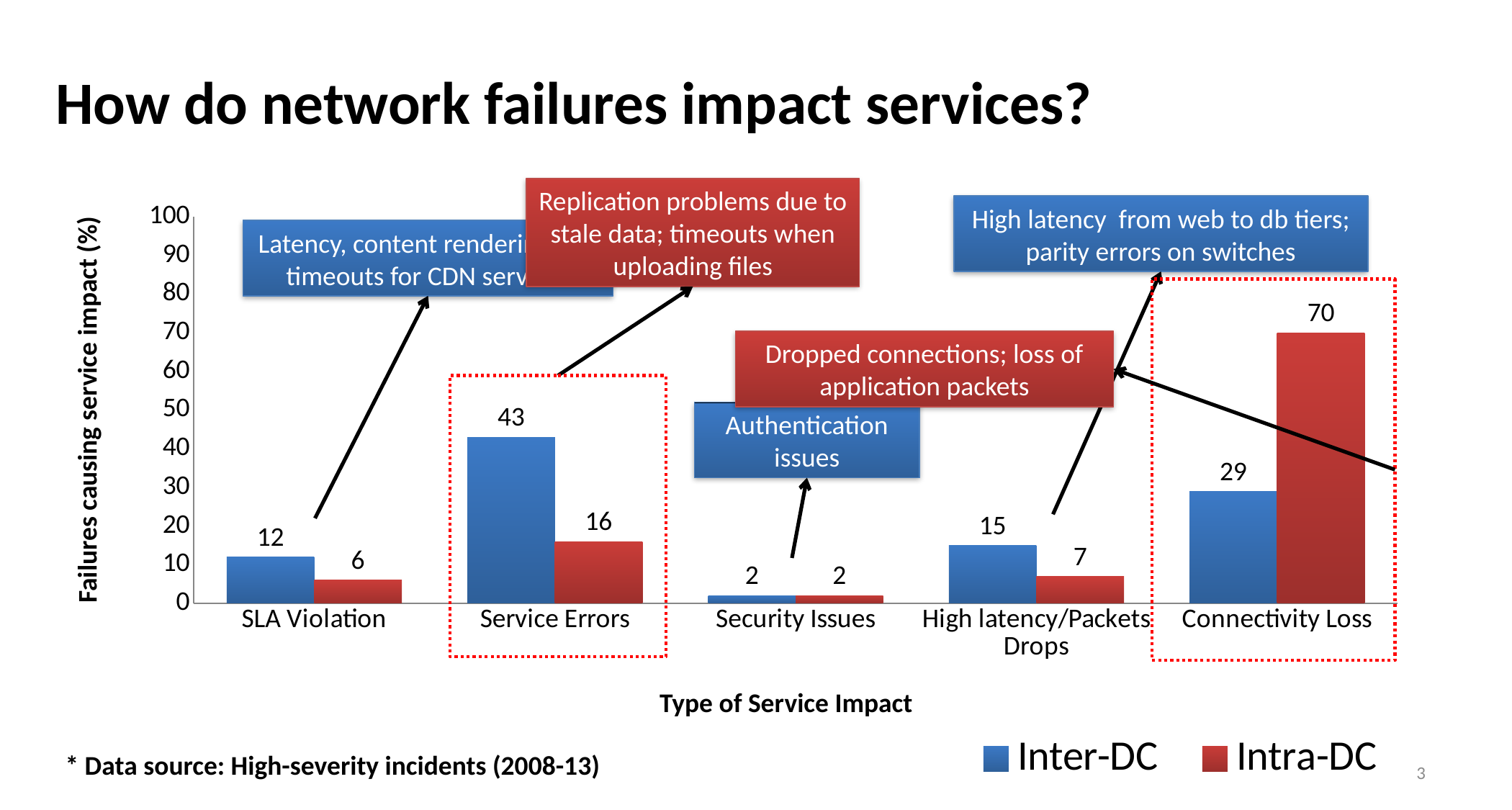
How many series does the legend list? 2 What is the label of the y axis? Failures causing service impact (%) Which category has the highest Inter-DC value? Service Errors What is the Intra-DC value for SLA Violation? 6 Which category has the lowest Intra-DC value? Security Issues What is the difference between the Intra-DC and Inter-DC values for Connectivity Loss? 41 What is the Inter-DC value for Service Errors? 43 What is the Inter-DC value for High latency/Packets Drops? 15 How many categories are shown on the x axis? 5 What kind of chart is shown on the slide? Bar chart Which is larger for Service Errors, the Inter-DC value or the Intra-DC value? Inter-DC What is the Intra-DC value for Connectivity Loss? 70